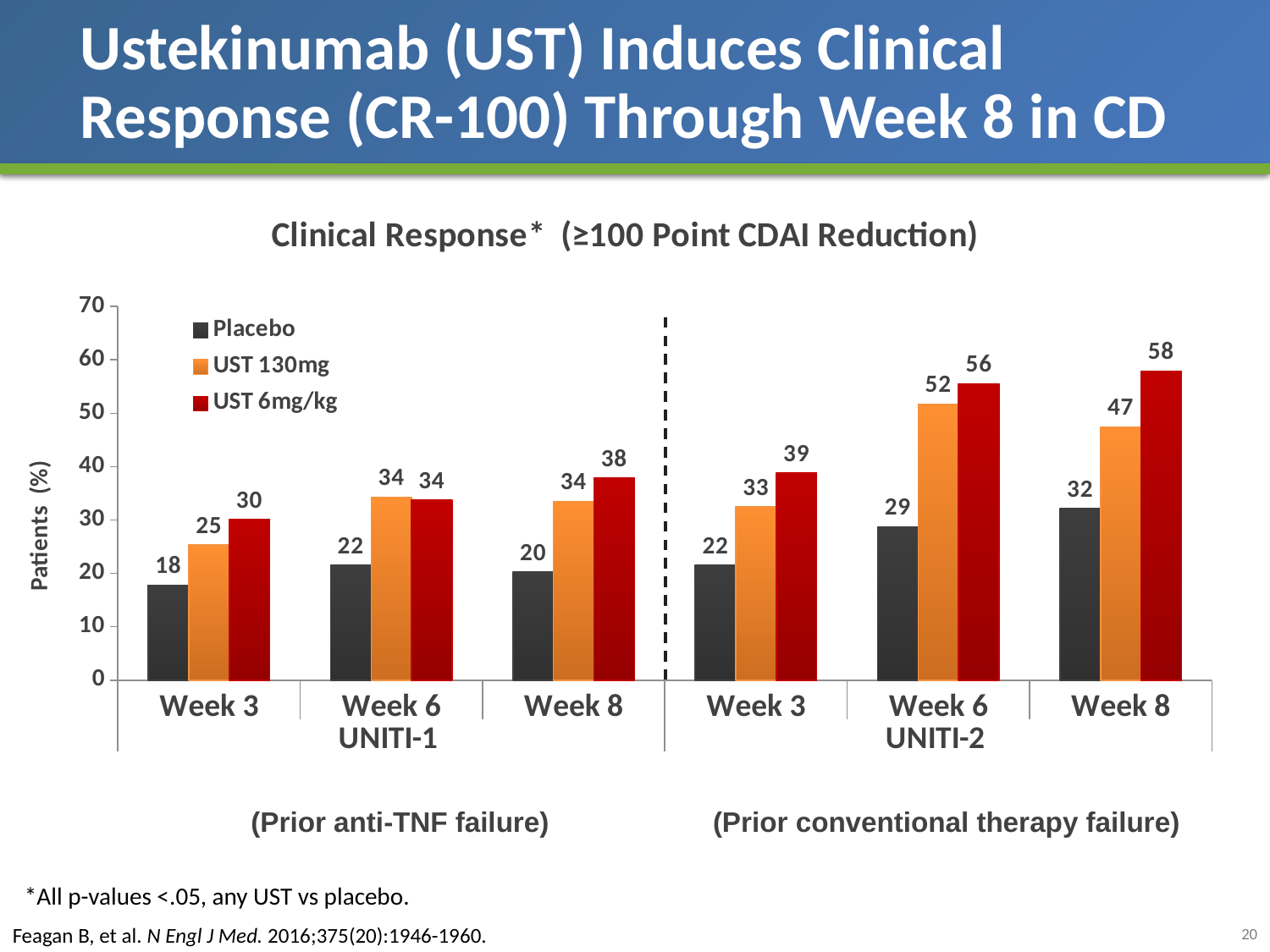
What kind of chart is shown on the slide? Bar chart What is the title of the chart? Clinical Response* (≥100 Point CDAI Reduction) What is the value for UST 6mg/kg at Week 8 in UNITI-2? 58 Is the value for UST 130mg at Week 8 in UNITI-2 greater or less than 40? greater Does the Placebo value in UNITI-2 rise or fall from Week 3 to Week 8? Rise What is the value for UST 130mg at Week 6 in UNITI-2? 52 Which series has the lowest value at Week 3 in UNITI-1? Placebo What is the value for Placebo at Week 3 in UNITI-1? 18 How many series does the legend list? 3 What is the difference between UST 6mg/kg and Placebo at Week 8 in UNITI-2? 26 Which series has the highest value at Week 8 in UNITI-2? UST 6mg/kg Which is larger: UST 6mg/kg at Week 8 in UNITI-1 or UST 6mg/kg at Week 8 in UNITI-2? UST 6mg/kg at Week 8 in UNITI-2